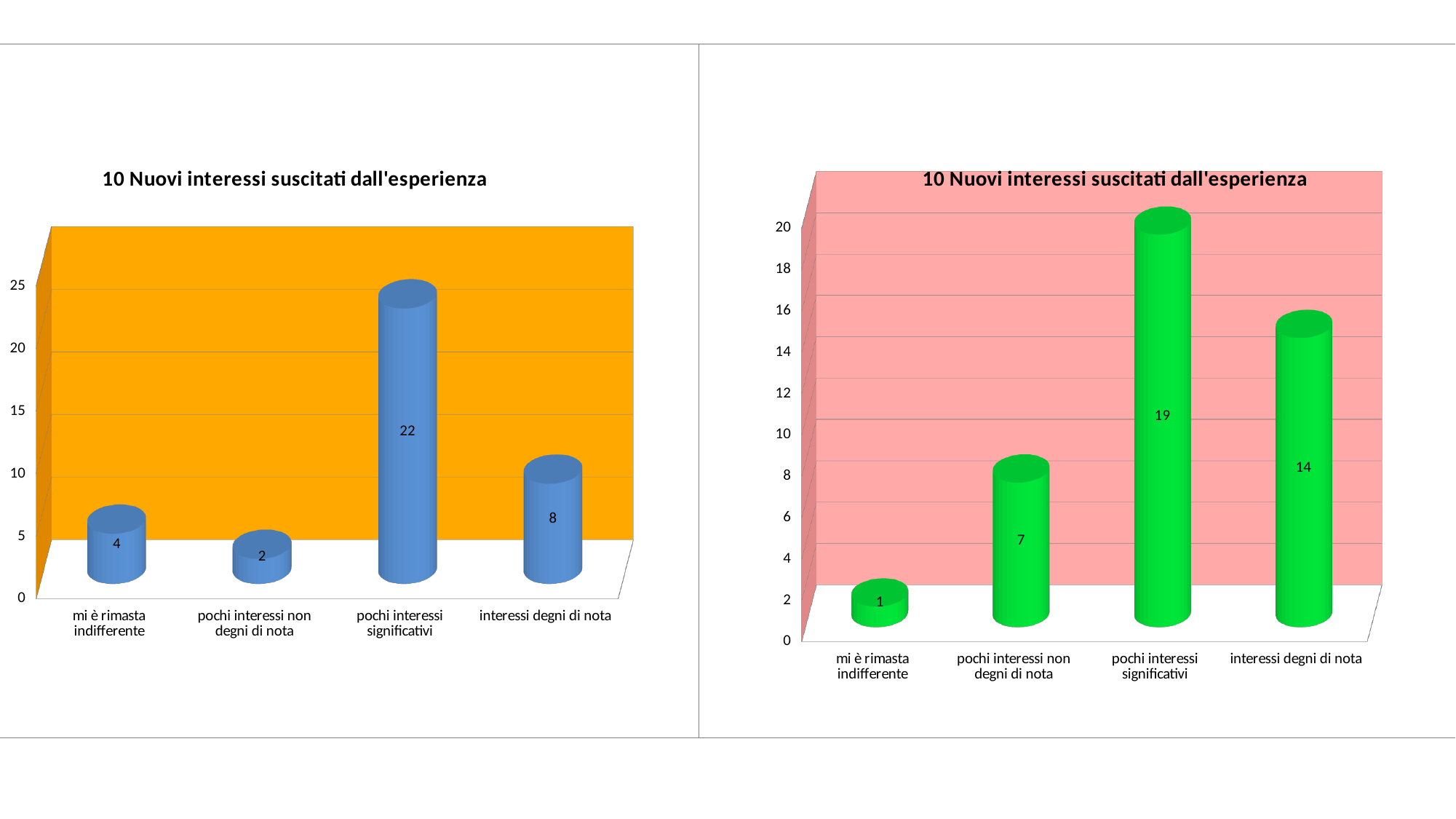
In the right chart, which category has the lowest value? mi è rimasta indifferente In the left chart, what is the difference between 'pochi interessi significativi' and 'interessi degni di nota'? 14 In the right chart, what is the value for 'interessi degni di nota'? 14 In the right chart, what is the difference between 'pochi interessi significativi' and 'pochi interessi non degni di nota'? 12 In the left chart, what is the value for 'pochi interessi significativi'? 22 In the left chart, which category has the lowest value? pochi interessi non degni di nota What kind of chart is the right chart? bar chart In the left chart, what is the value for 'mi è rimasta indifferente'? 4 How many categories does the left chart show? 4 In the right chart, which is larger: 'pochi interessi non degni di nota' or 'interessi degni di nota'? interessi degni di nota In the right chart, which category has the highest value? pochi interessi significativi What is the title of the left chart? 10 Nuovi interessi suscitati dall'esperienza